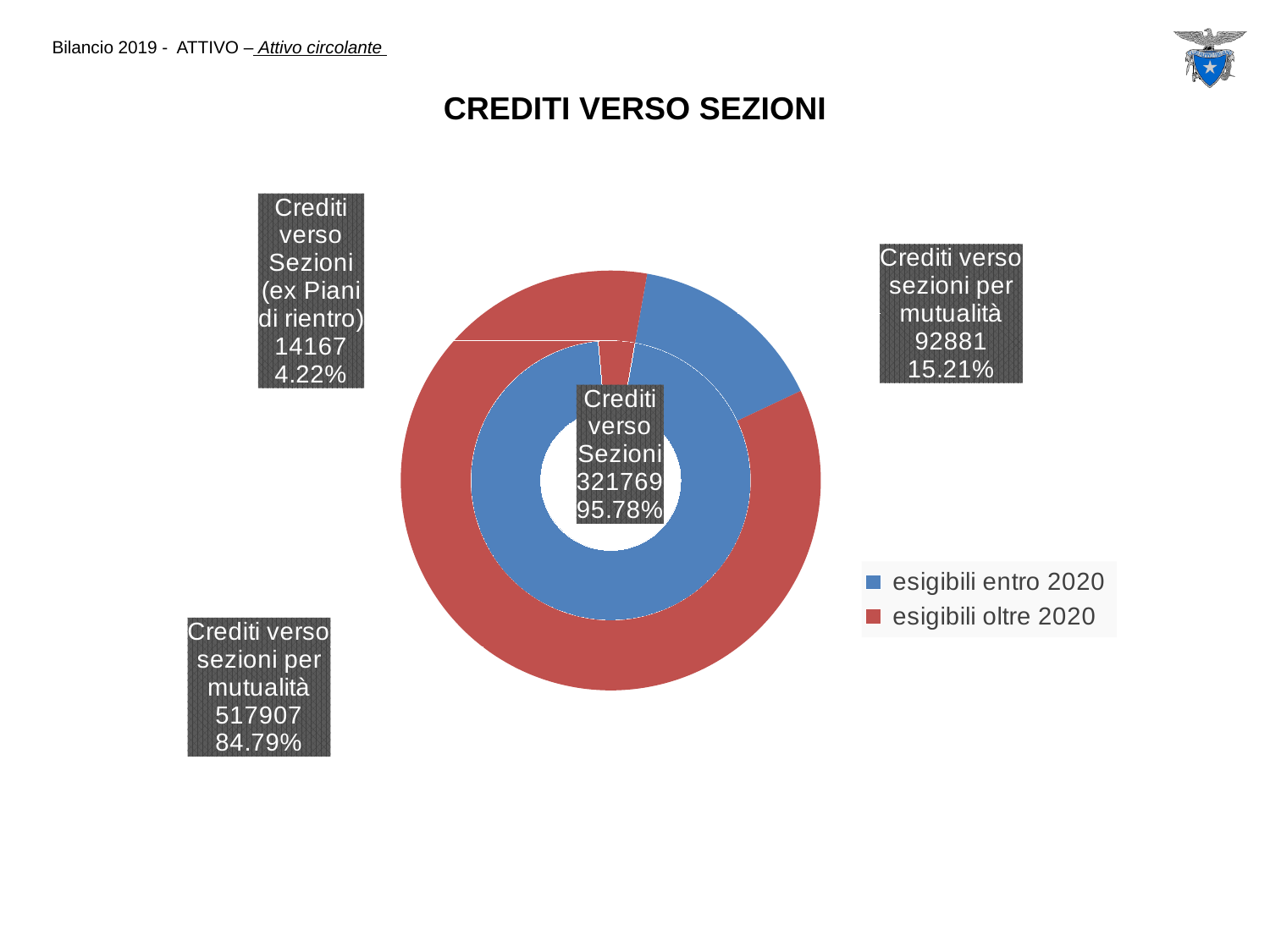
What kind of chart is shown on the slide? doughnut chart Which is larger: 'Crediti verso Sezioni' (321769) or 'Crediti verso Sezioni (ex Piani di rientro)' (14167)? Crediti verso Sezioni What percentage share is shown for 'Crediti verso Sezioni' in the inner ring? 95.78% What value is shown for 'Crediti verso Sezioni (ex Piani di rientro)'? 14167 What percentage share is shown for 'Crediti verso Sezioni (ex Piani di rientro)'? 4.22% What is the title of the chart? CREDITI VERSO SEZIONI What percentage share is shown for the 'Crediti verso sezioni per mutualità' slice with value 92881? 15.21% What is the larger value shown for 'Crediti verso sezioni per mutualità' in the outer ring? 517907 What is the difference between the two 'Crediti verso sezioni per mutualità' values, 517907 and 92881? 425026 Which legend entry is shown in red? esigibili oltre 2020 How many entries does the legend list? 2 What value is shown for 'Crediti verso Sezioni' in the inner ring? 321769